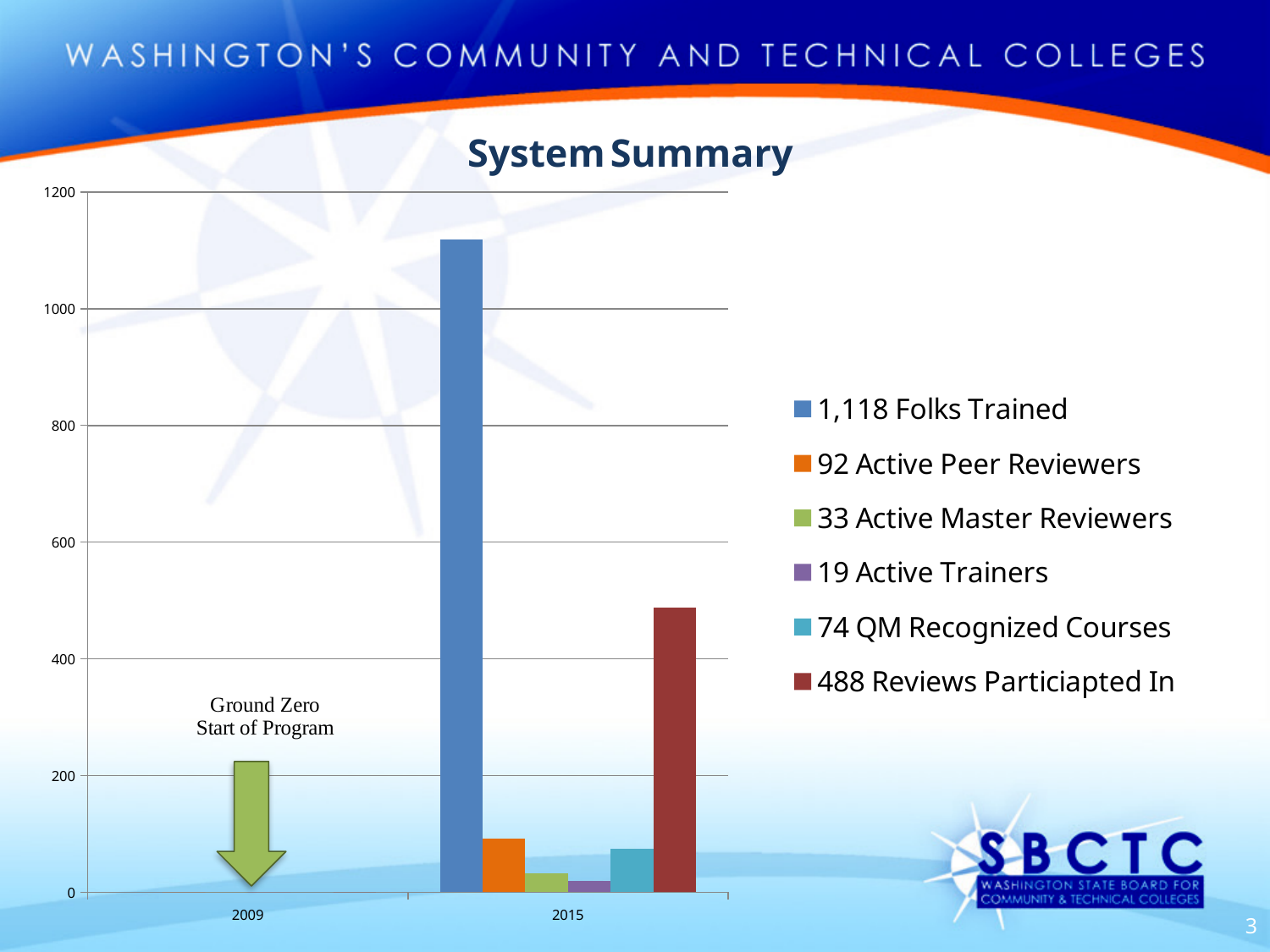
Which series has the tallest bar in 2015? 1,118 Folks Trained Is the value for Reviews Participated In greater or less than 400? greater What kind of chart is shown on the slide? bar chart According to the legend, how many Folks Trained are shown for 2015? 1,118 According to the legend, how many Active Peer Reviewers are there? 92 Which series has the shortest bar in 2015? 19 Active Trainers According to the legend, how many Reviews Participated In are shown? 488 What is the difference between the number of Active Peer Reviewers and the number of Active Master Reviewers? 59 How many series does the chart legend list? 6 How many categories are shown on the x axis? 2 Which is larger in 2015: QM Recognized Courses or Active Peer Reviewers? Active Peer Reviewers What is the title of the chart? System Summary